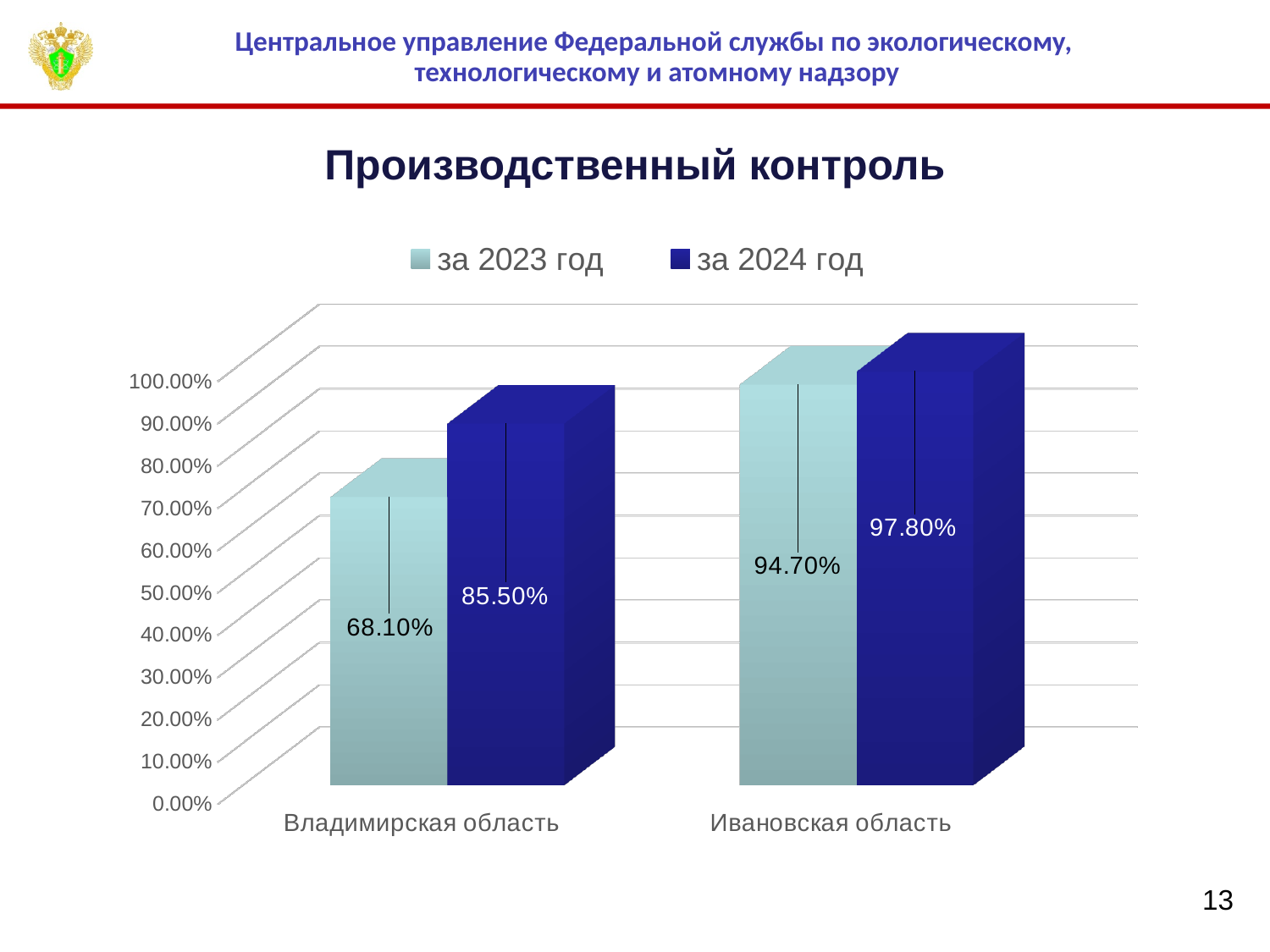
Which is larger for Ивановская область: the value for за 2023 год or за 2024 год? за 2024 год How many series does the legend list? 2 What is the value for Ивановская область in the series за 2024 год? 97.80% What is the title of the chart? Производственный контроль What is the difference between the за 2024 год and за 2023 год values for Владимирская область? 17.40% Which category has the highest value in the series за 2024 год? Ивановская область Which category has the lowest value in the series за 2023 год? Владимирская область What kind of chart is shown on the slide? Bar chart What is the value for Ивановская область in the series за 2023 год? 94.70% How many categories are shown on the x axis? 2 What is the value for Владимирская область in the series за 2024 год? 85.50% What is the value for Владимирская область in the series за 2023 год? 68.10%